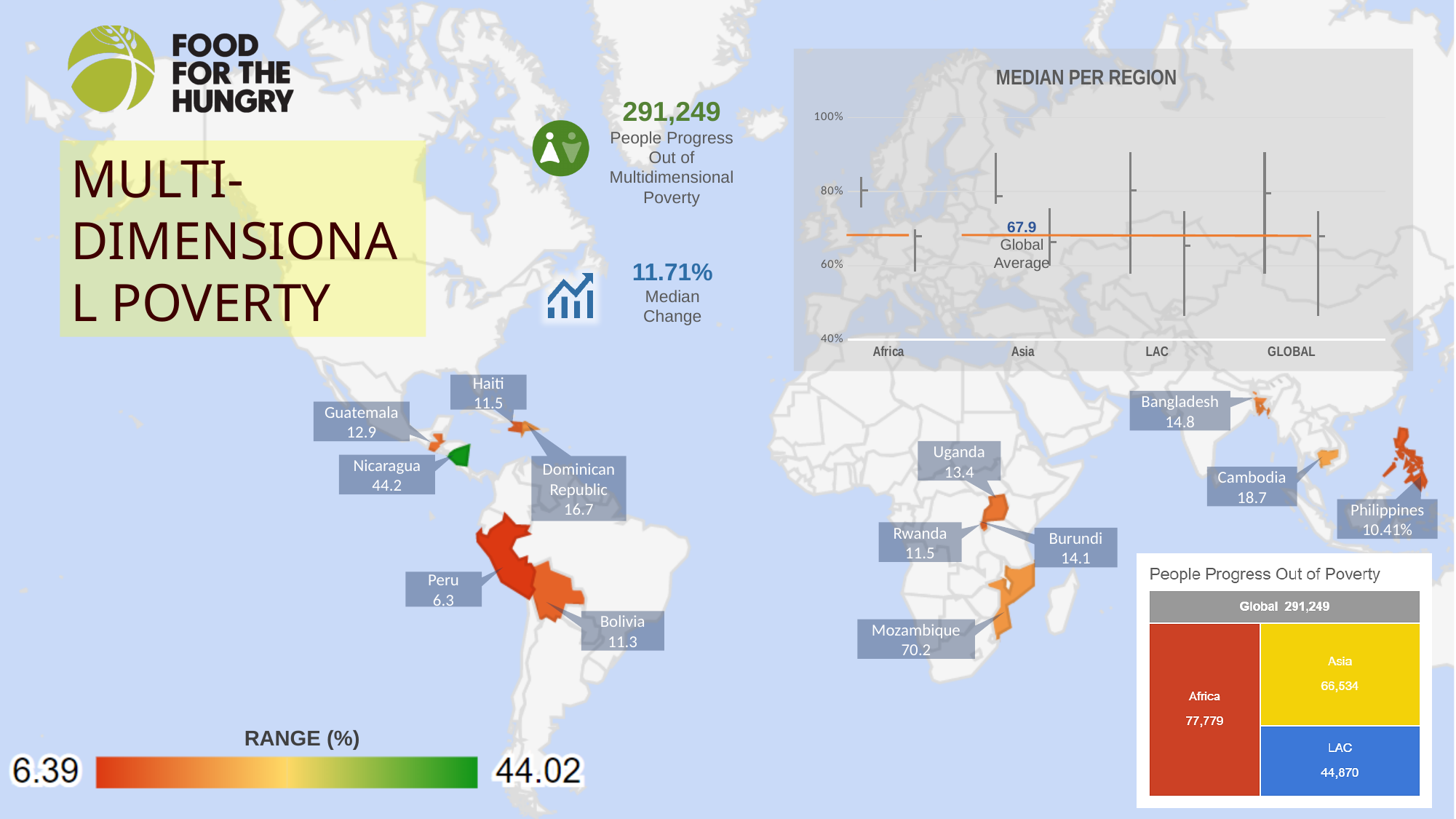
On the map, what is the value shown for Nicaragua? 44.2 In the 'People Progress Out of Poverty' treemap, what is the Global total shown? 291,249 In the 'People Progress Out of Poverty' treemap, what is the value for LAC? 44,870 On the map, which labelled country has the highest value? Mozambique In the 'People Progress Out of Poverty' treemap, which region has the highest value? Africa In the 'People Progress Out of Poverty' treemap, which is larger, Asia or LAC? Asia In the 'People Progress Out of Poverty' treemap, what is the value for Asia? 66,534 In the 'People Progress Out of Poverty' treemap, what is the difference between the Africa and Asia values? 11,245 In the 'MEDIAN PER REGION' chart, what is the Global Average value labelled on the orange line? 67.9 In the 'MEDIAN PER REGION' chart, how many categories are shown on the x axis? 4 In the 'People Progress Out of Poverty' treemap, which region has the lowest value? LAC In the 'People Progress Out of Poverty' treemap, what is the value for Africa? 77,779